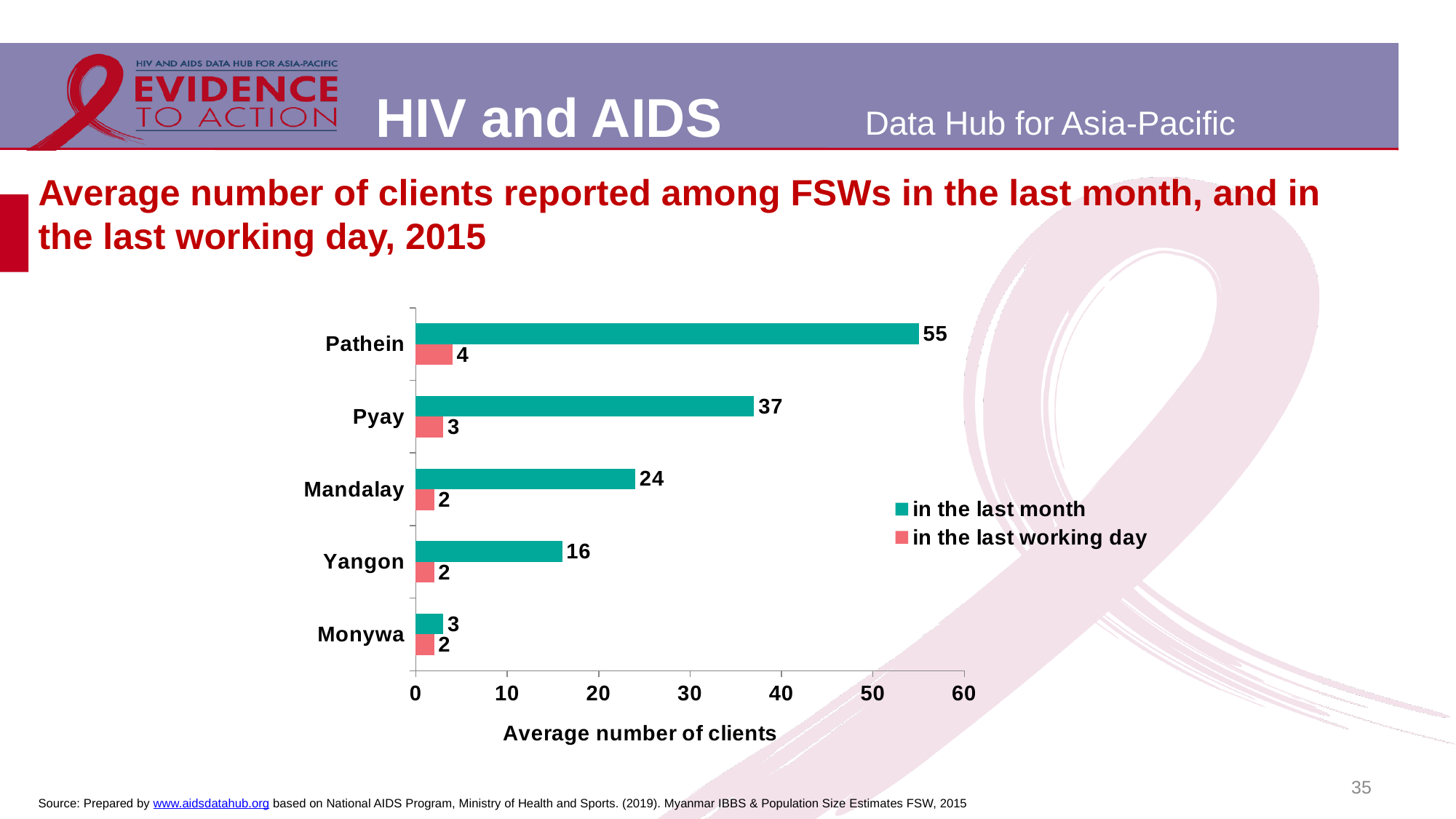
What is the label of the x axis? Average number of clients Which city has the highest average number of clients in the last month? Pathein What is the difference between the average number of clients in the last month for Pathein and Pyay? 18 What is the average number of clients in the last month for Mandalay? 24 Which city has the lowest average number of clients in the last month? Monywa How many series does the legend list? 2 Is the value for Pyay in the last month greater or less than 30? greater Which is larger: the average number of clients in the last month for Yangon or for Mandalay? Mandalay How many cities are shown on the chart? 5 What is the average number of clients in the last working day for Pyay? 3 What kind of chart is shown on the slide? Bar chart What is the average number of clients in the last month for Pathein? 55